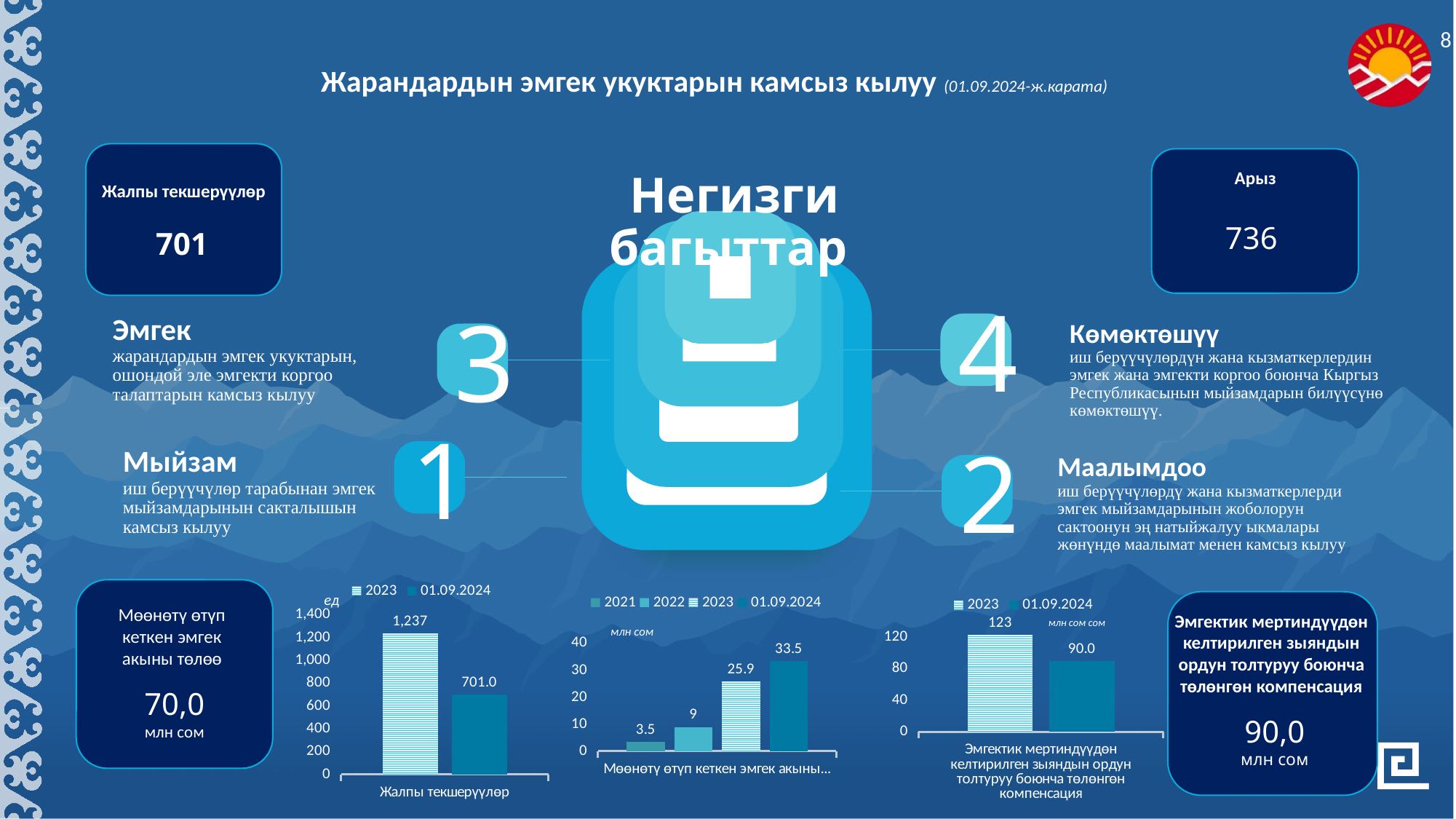
In the middle chart (Мөөнөтү өтүп кеткен эмгек акыны...), what is the value for 2021? 3.5 In the left chart (Жалпы текшерүүлөр), which series has the higher value, 2023 or 01.09.2024? 2023 In the left chart (Жалпы текшерүүлөр), how many series does the legend list? 2 In the middle chart (Мөөнөтү өтүп кеткен эмгек акыны...), what is the difference between the 01.09.2024 value and the 2023 value? 7.6 In the right chart (Эмгектик мертиндүүдөн келтирилген зыяндын ордун толтуруу боюнча төлөнгөн компенсация), what is the value for 2023? 123 In the middle chart (Мөөнөтү өтүп кеткен эмгек акыны...), how many series does the legend list? 4 In the middle chart (Мөөнөтү өтүп кеткен эмгек акыны...), which series has the lowest value? 2021 In the left chart (Жалпы текшерүүлөр), what is the value for 01.09.2024? 701.0 In the left chart (Жалпы текшерүүлөр), what is the value for 2023? 1,237 In the middle chart (Мөөнөтү өтүп кеткен эмгек акыны...), which series has the highest value? 01.09.2024 What type of chart is the right chart (Эмгектик мертиндүүдөн келтирилген зыяндын ордун толтуруу боюнча төлөнгөн компенсация)? bar chart In the middle chart (Мөөнөтү өтүп кеткен эмгек акыны...), what is the value for 2023? 25.9